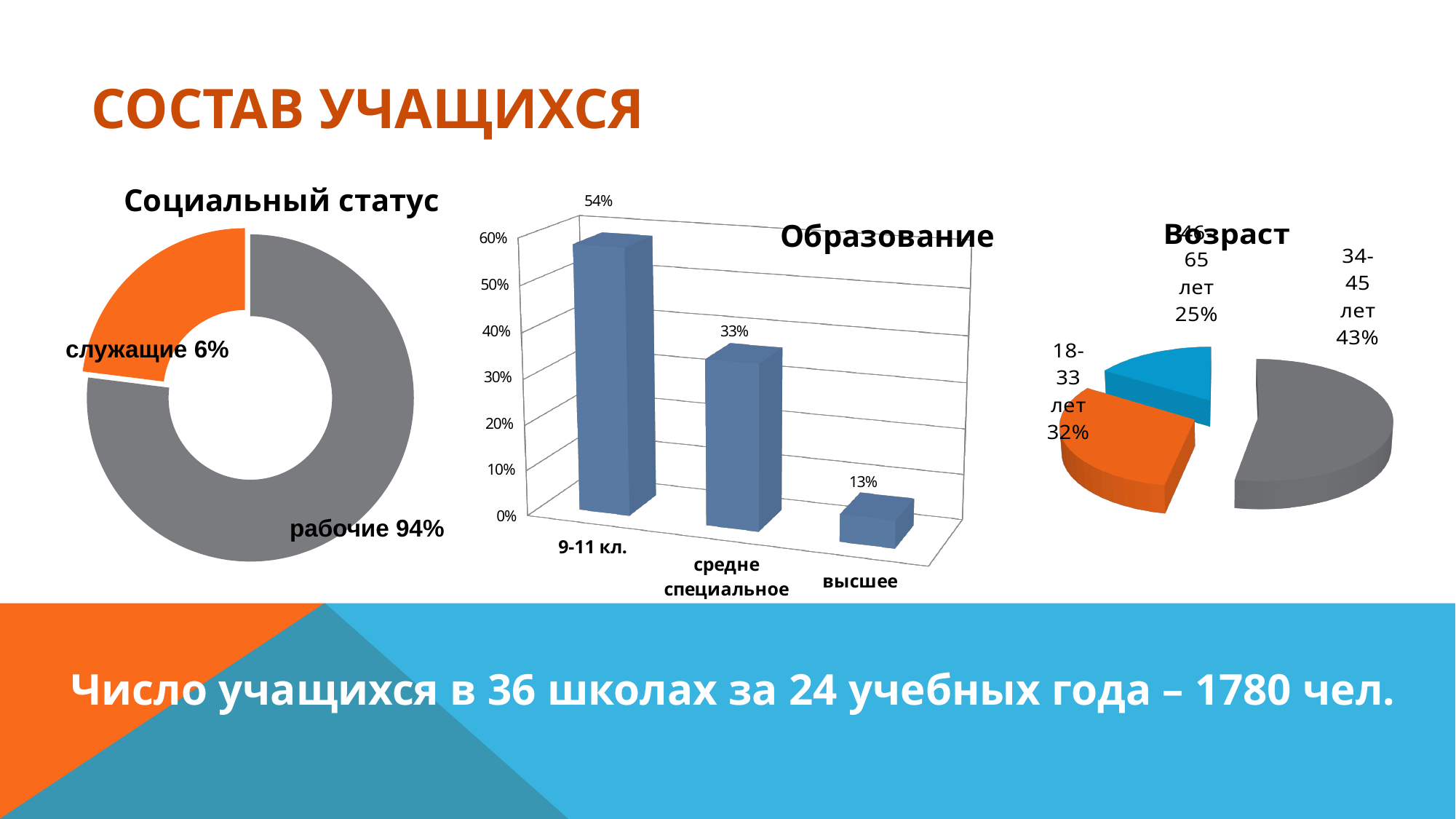
In the 'Возраст' chart, what is the share for 34-45 лет? 43% In the 'Образование' chart, what is the value for высшее? 13% What kind of chart is the 'Образование' chart? Bar chart In the 'Образование' chart, what is the difference between 9-11 кл. and средне специальное? 21% In the 'Образование' chart, what is the value for 9-11 кл.? 54% In the 'Образование' chart, which category has the lowest value? высшее In the 'Возраст' chart, what colour is the 18-33 лет slice? Orange In the 'Социальный статус' chart, what is the value for служащие? 6% In the 'Образование' chart, how many categories are shown? 3 In the 'Социальный статус' chart, what is the value for рабочие? 94% In the 'Возраст' chart, which is larger: 18-33 лет or 34-45 лет? 34-45 лет What kind of chart is the 'Социальный статус' chart? Donut chart